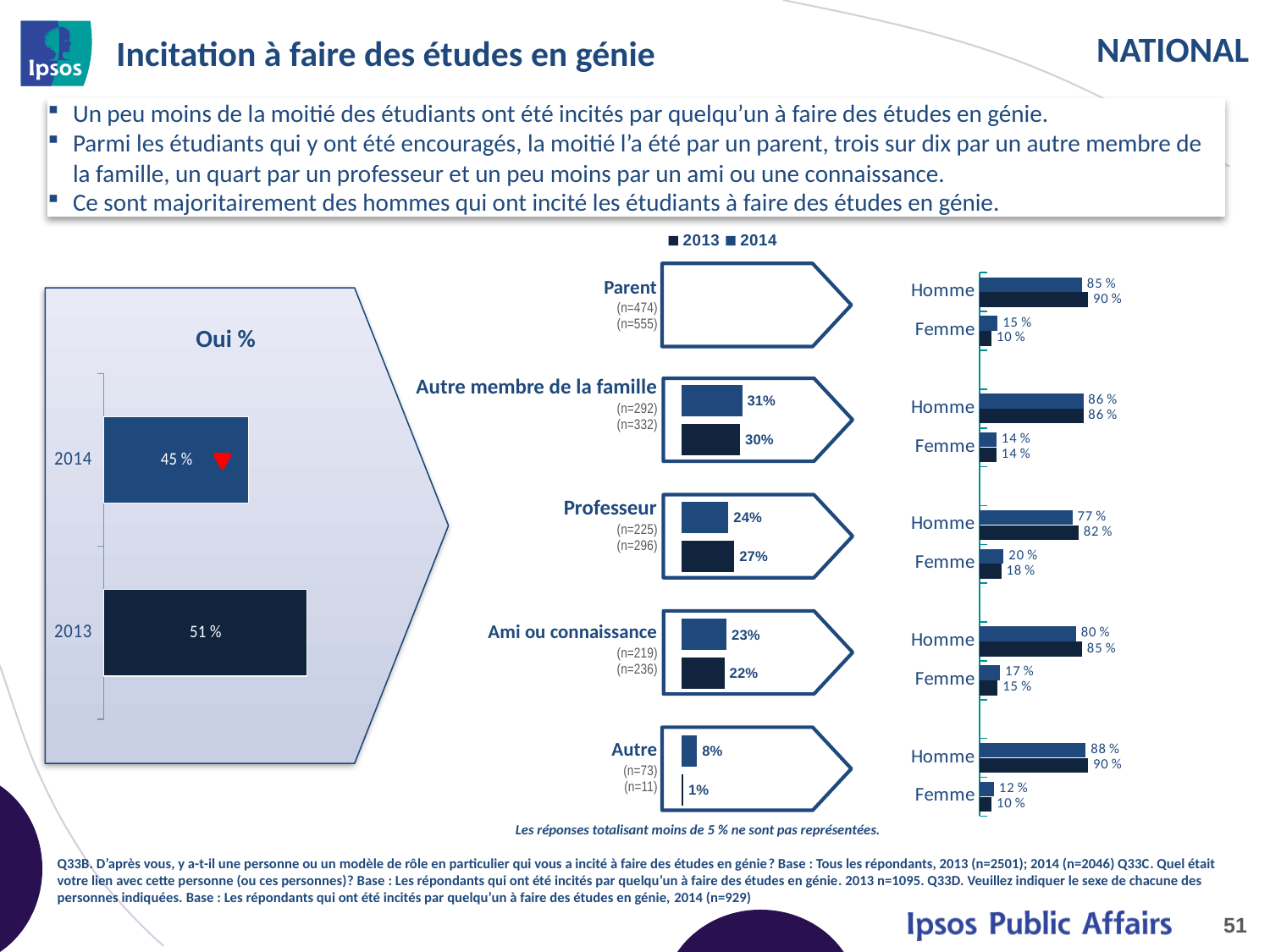
In the 'Oui %' chart on the left, what is the value for 2013? 51 % In the right-hand chart of gender by relationship type, what is the 2014 value for 'Homme' under 'Parent'? 85 % How many series does the legend at the top of the charts list? 2 In the middle chart of relationship types, what is the 2014 value for 'Professeur'? 24% In the right-hand chart of gender by relationship type, what is the 2013 value for 'Femme' under 'Professeur'? 18 % In the middle chart of relationship types, which is larger for 'Ami ou connaissance': the 2013 value or the 2014 value? 2014 What type of chart is the 'Oui %' chart on the left? Bar chart In the middle chart of relationship types, what is the 2013 value for 'Autre membre de la famille'? 30% In the middle chart of relationship types, what is the 2014 value for 'Autre'? 8% In the 'Oui %' chart on the left, what is the value for 2014? 45 % In the right-hand chart of gender by relationship type, what is the difference between the 2014 'Homme' and 2014 'Femme' values under 'Ami ou connaissance'? 63 In the 'Oui %' chart on the left, by how many percentage points does the 2013 value exceed the 2014 value? 6